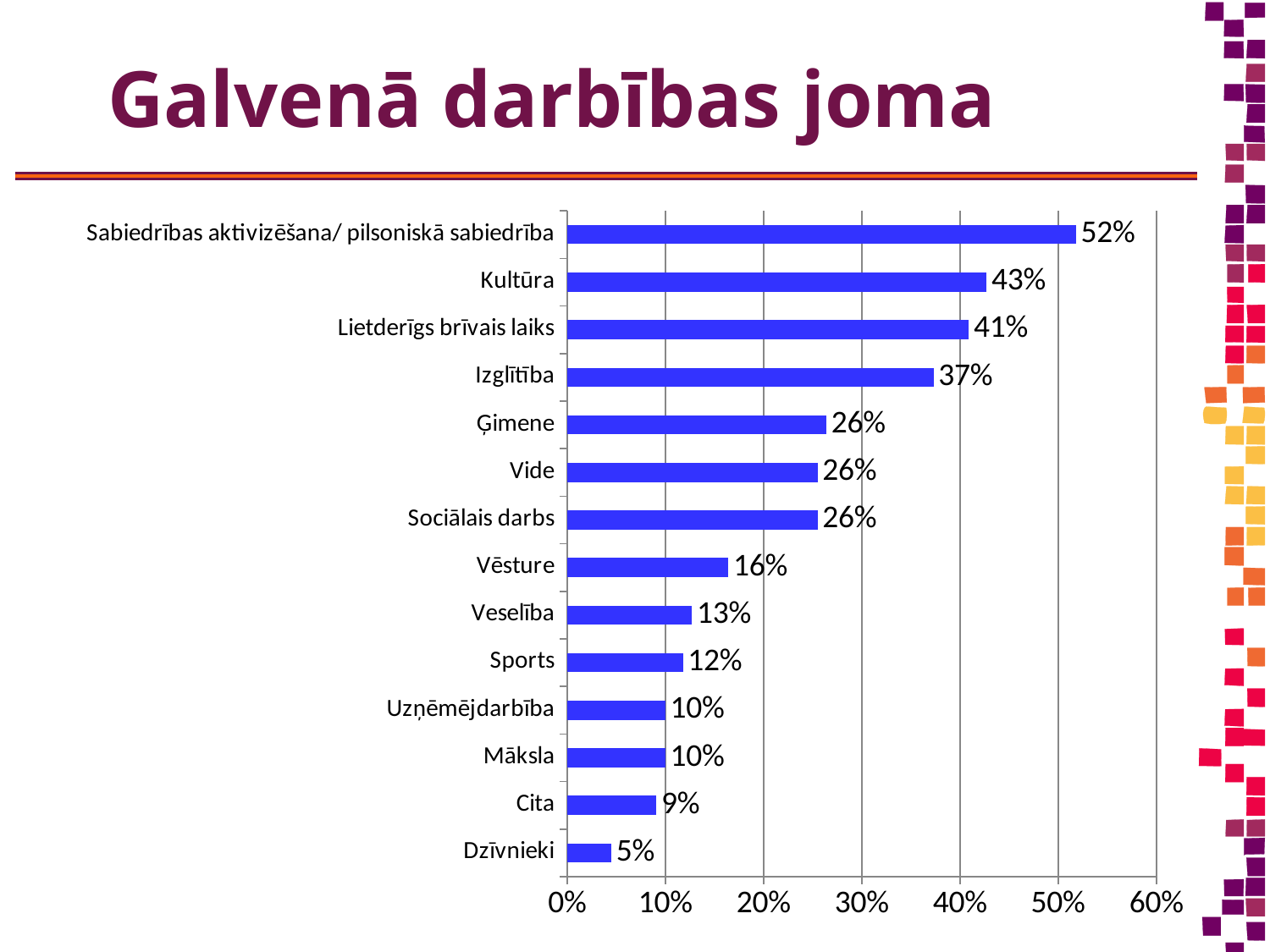
Which category has the highest value? Sabiedrības aktivizēšana/ pilsoniskā sabiedrība What kind of chart is shown on the slide? bar chart How many categories are shown in the chart? 14 What is the highest value shown on the horizontal axis? 60% Which is larger, the value for Veselība or the value for Sports? Veselība What is the value for Dzīvnieki? 5% Which category has the lowest value? Dzīvnieki What is the title of the slide? Galvenā darbības joma What is the value for Kultūra? 43% What is the value for Vēsture? 16% Is the value for Lietderīgs brīvais laiks greater or less than 30%? greater What is the difference between the values for Kultūra and Izglītība? 6%